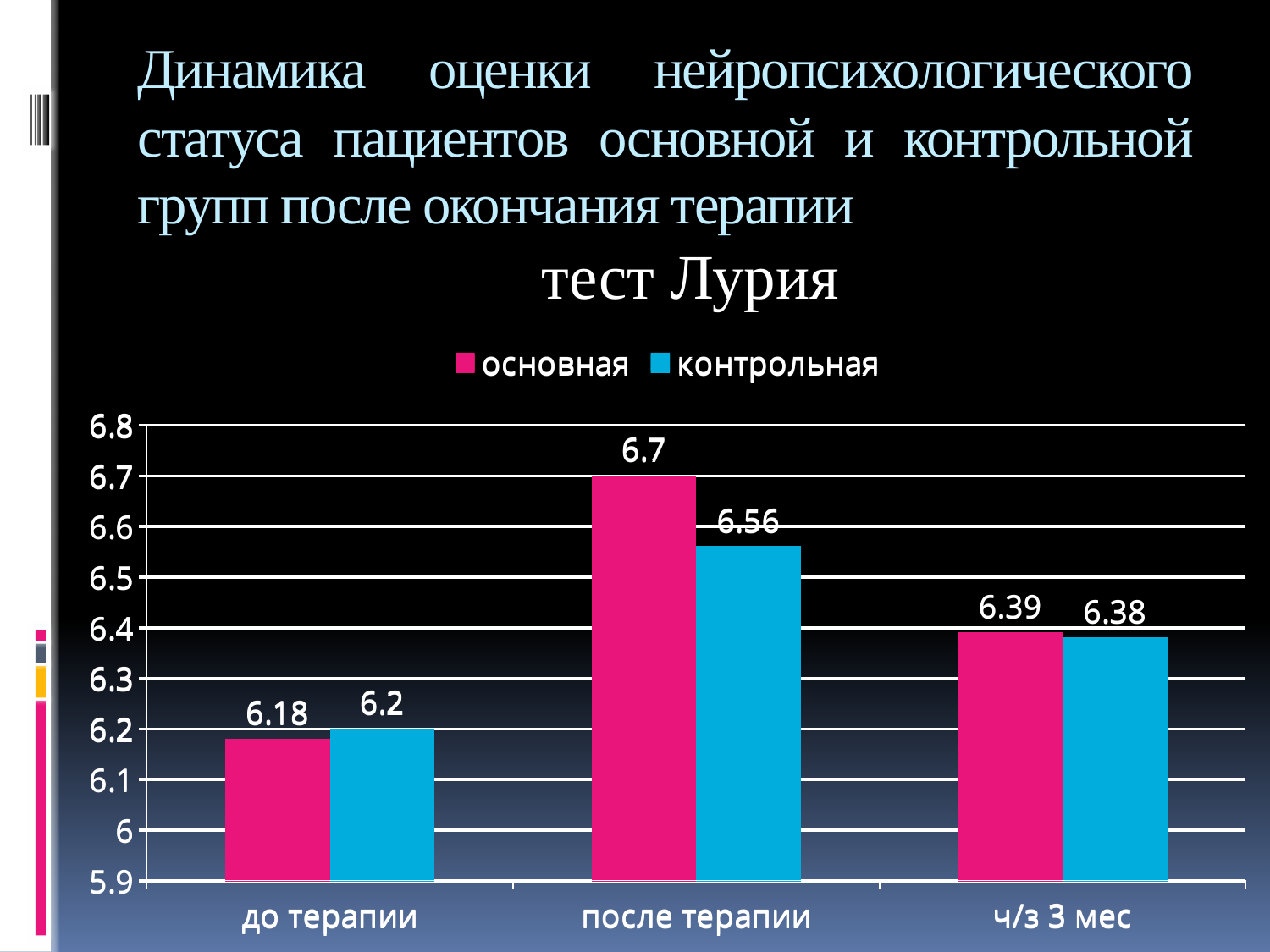
What is the title of the chart? тест Лурия How many series does the legend list? 2 What is the value for основная at ч/з 3 мес? 6.39 What is the value for контрольная at после терапии? 6.56 What is the value for контрольная at до терапии? 6.2 What is the difference between основная and контрольная at после терапии? 0.14 How many categories are shown on the x axis? 3 Which is larger at до терапии, основная or контрольная? контрольная At which category is the value for контрольная lowest? до терапии What is the value for основная at до терапии? 6.18 At which category does основная reach its highest value? после терапии What kind of chart is shown? bar chart